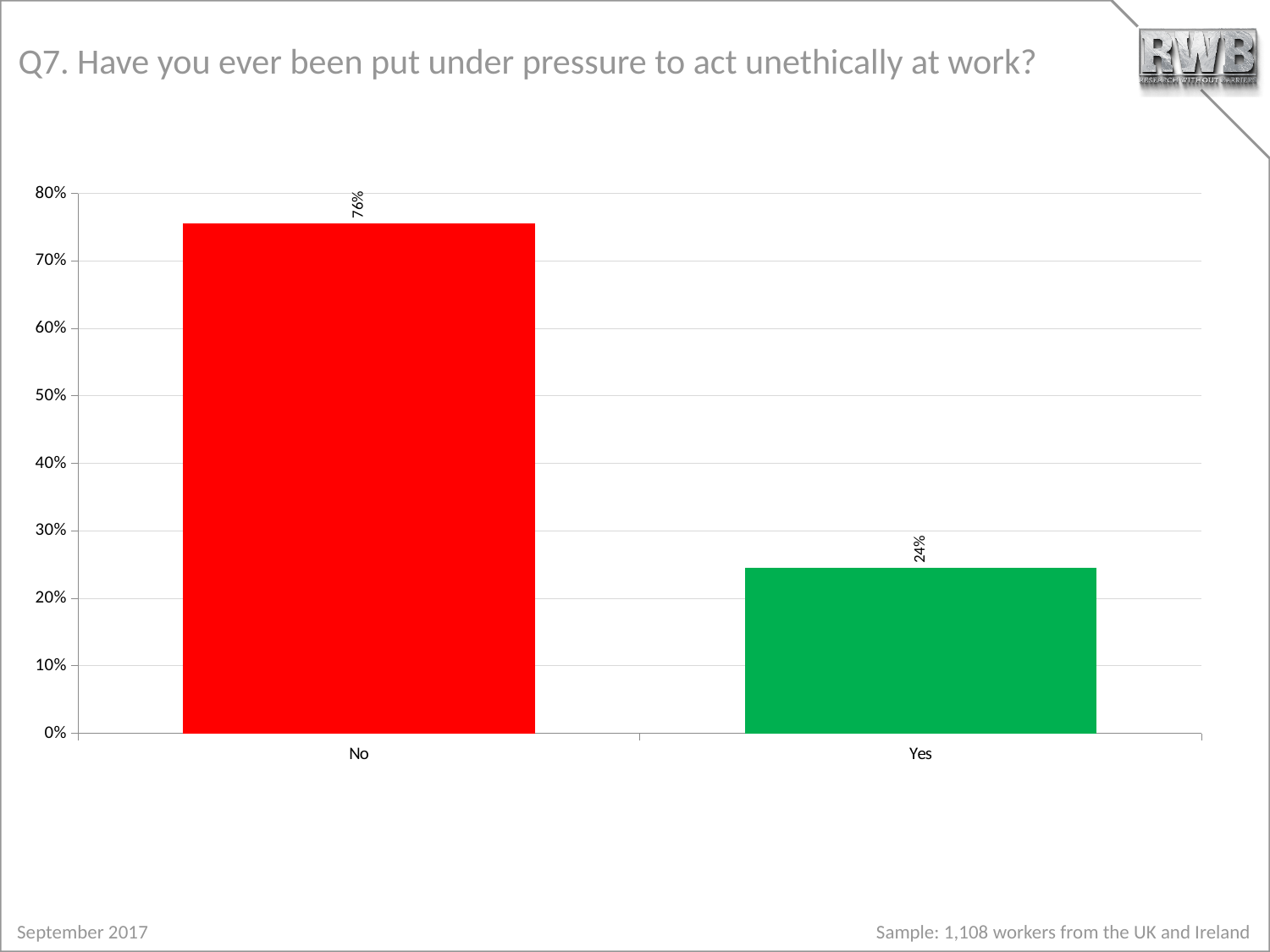
What is the difference in percentage points between the "No" and "Yes" responses? 52 percentage points How many response categories are shown on the x axis? 2 Which response category has the lowest value? Yes What percentage of respondents answered "No"? 76% Is the value for "No" greater or less than 70%? greater What colour is the bar for "Yes"? green What percentage of respondents answered "Yes"? 24% What is the title of the chart? Q7. Have you ever been put under pressure to act unethically at work? What kind of chart is shown on the slide? bar chart Which response category has the highest value? No Is the value for "Yes" greater or less than 30%? less Which is larger, the value for "No" or the value for "Yes"? No